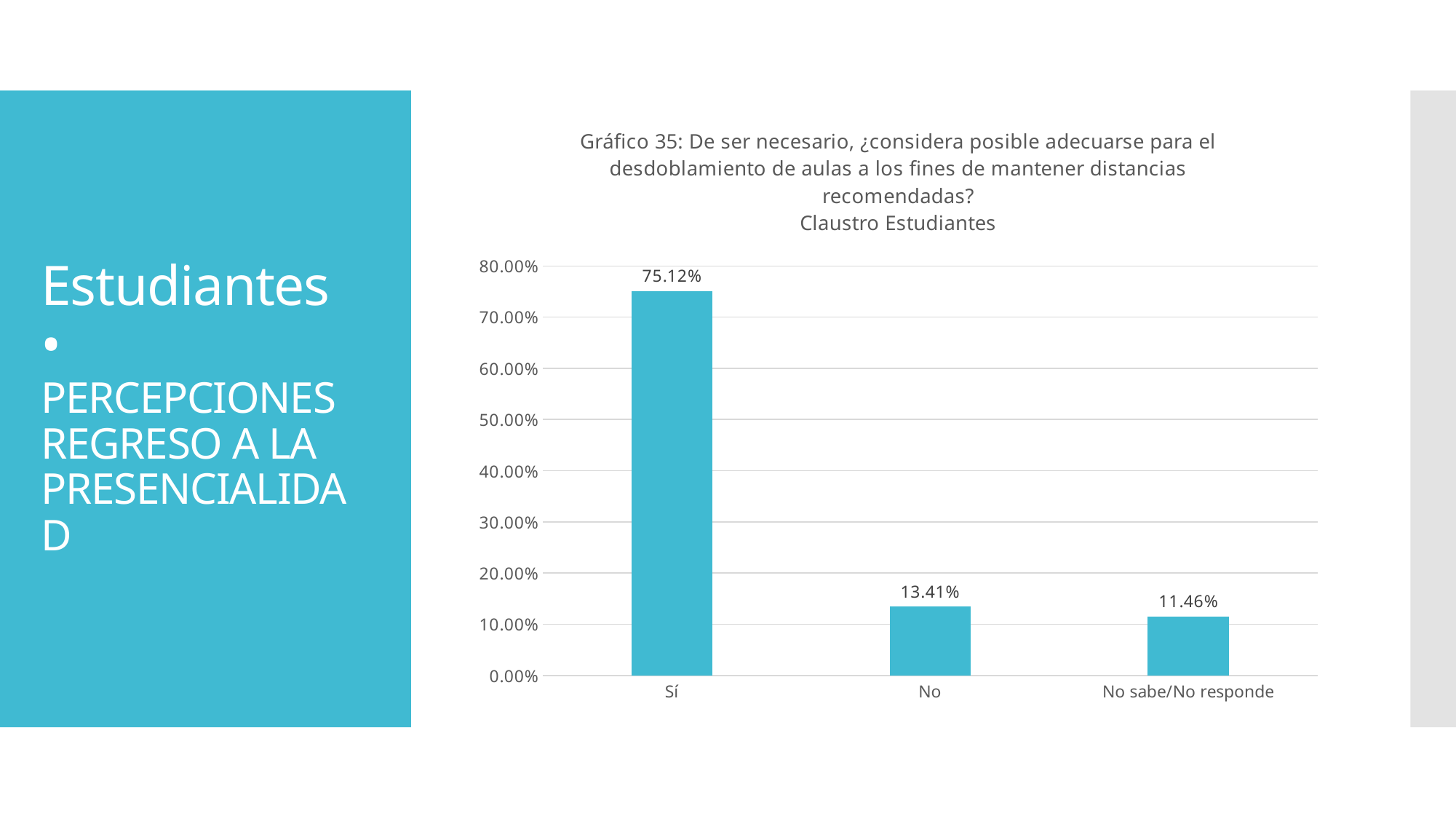
Is the value for "Sí" greater or less than 70.00%? greater How many categories are shown on the x axis? 3 What is the value for "No"? 13.41% Which is larger, the value for "Sí" or the value for "No"? Sí What kind of chart is shown on the slide? bar chart What is the value for "Sí"? 75.12% Which claustro (group) does the chart title say the data is for? Claustro Estudiantes Which category has the lowest value? No sabe/No responde Which category has the highest value? Sí What is the value for "No sabe/No responde"? 11.46% What is the difference between the values for "No" and "No sabe/No responde"? 1.95% What is the difference between the values for "Sí" and "No"? 61.71%